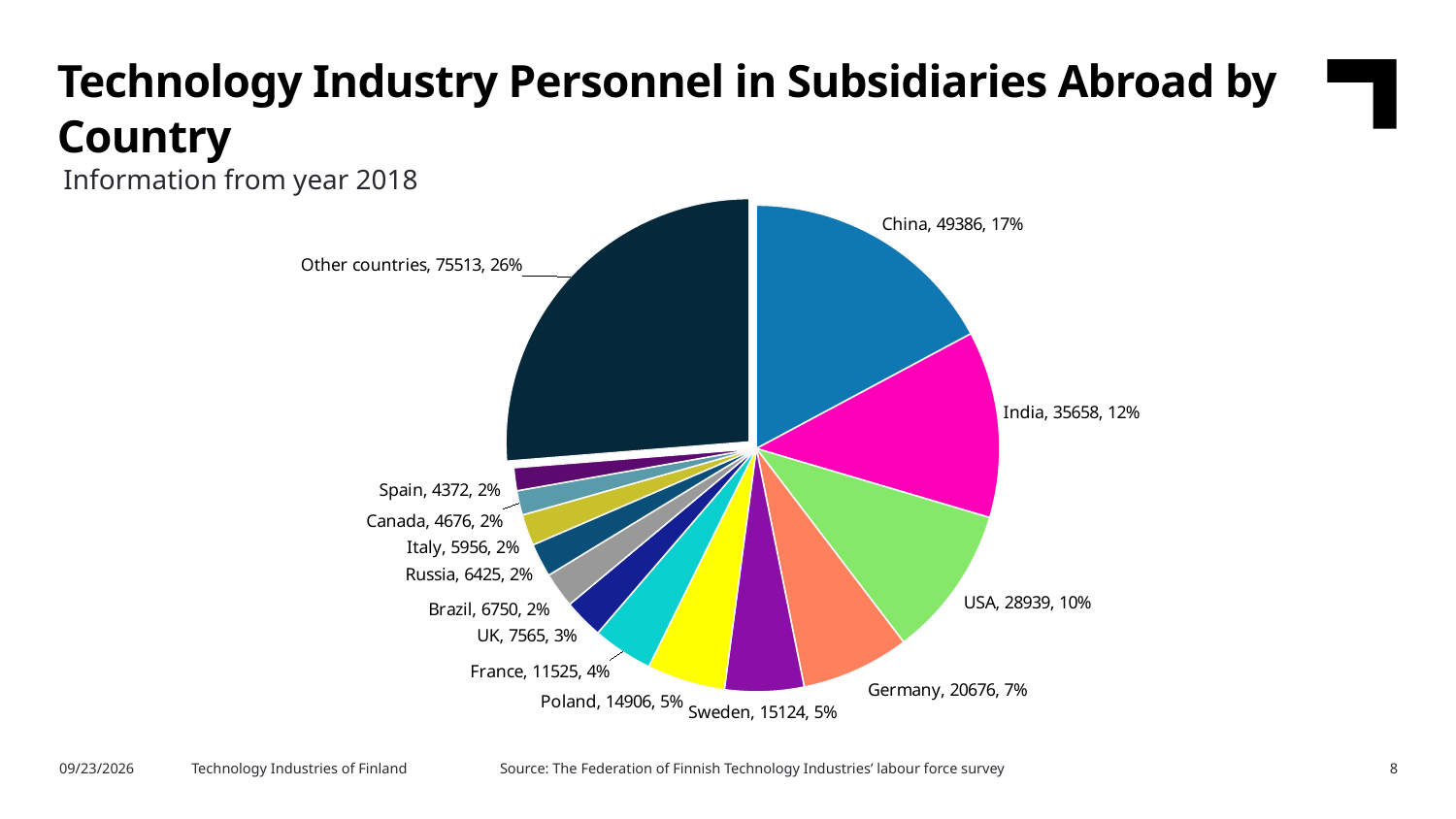
How many personnel does the chart show for China? 49386 Which single named country has the largest slice of the pie? China What share of the pie does Other countries represent? 26% What is the value shown for Germany? 20676 Which slice of the pie is the smallest? Spain What is the difference between the values for Sweden and Poland? 218 What type of chart is shown on the slide? pie chart What share of the pie does India represent? 12% How many slices does the pie chart have? 14 What year does the chart's information come from, according to the subtitle? 2018 What is the difference between the values for China and India? 13728 Which is larger, the value for USA or the value for Germany? USA